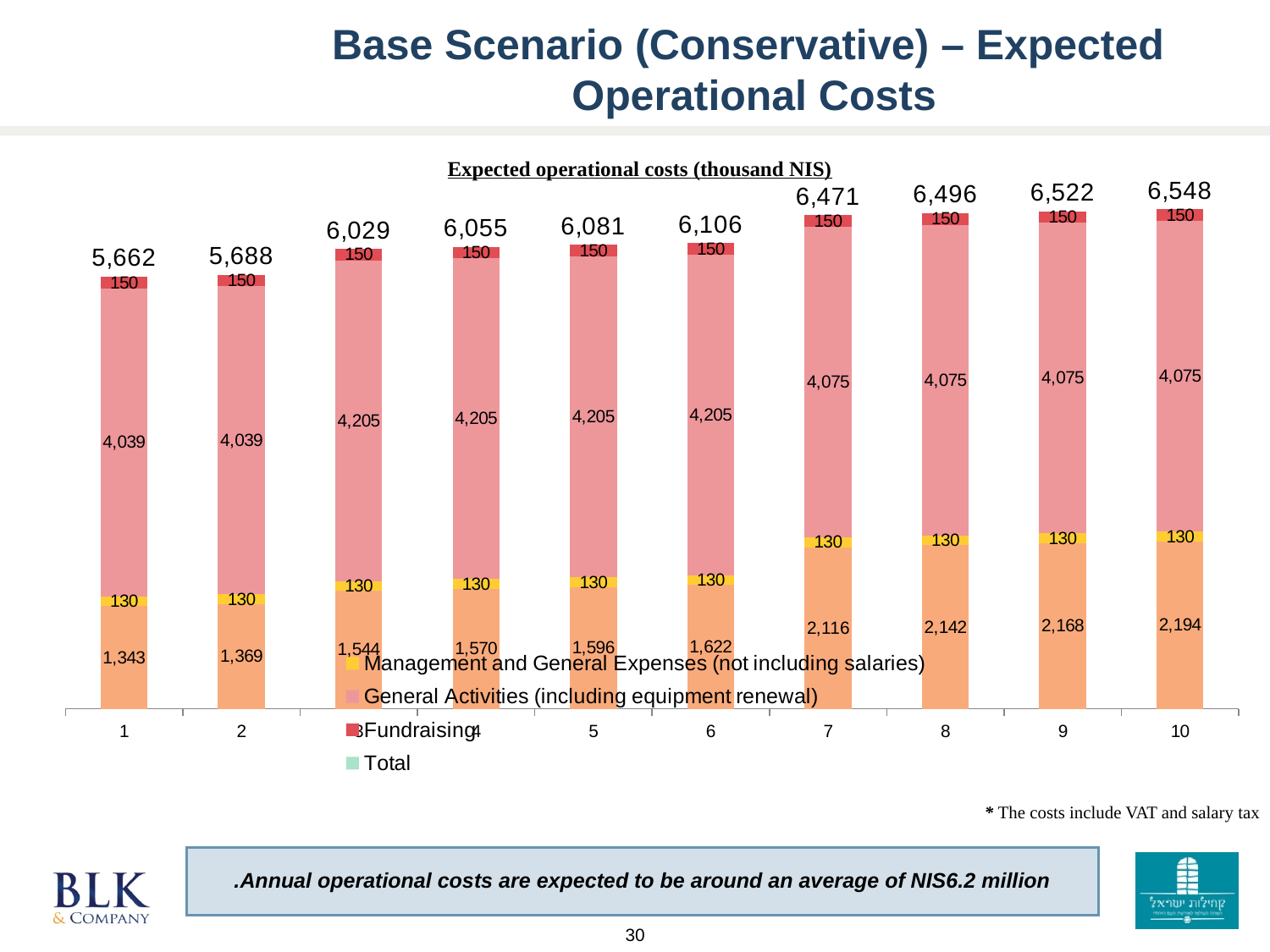
Which year has the lowest total expected operational cost? 1 Do the total expected operational costs rise or fall from year 1 to year 10? Rise What is the value of General Activities (including equipment renewal) in year 3? 4,205 Which year has the highest total expected operational cost? 10 How many years (categories) are shown on the x axis of the chart? 10 What is the total expected operational cost for year 10? 6,548 What is the total expected operational cost for year 1? 5,662 What is the difference between the total cost in year 10 and the total cost in year 1? 886 What is the title of the chart? Expected operational costs (thousand NIS) What is the value of General Activities (including equipment renewal) in year 7? 4,075 What is the Fundraising value in year 5? 150 What type of chart is shown on the slide? Stacked bar chart